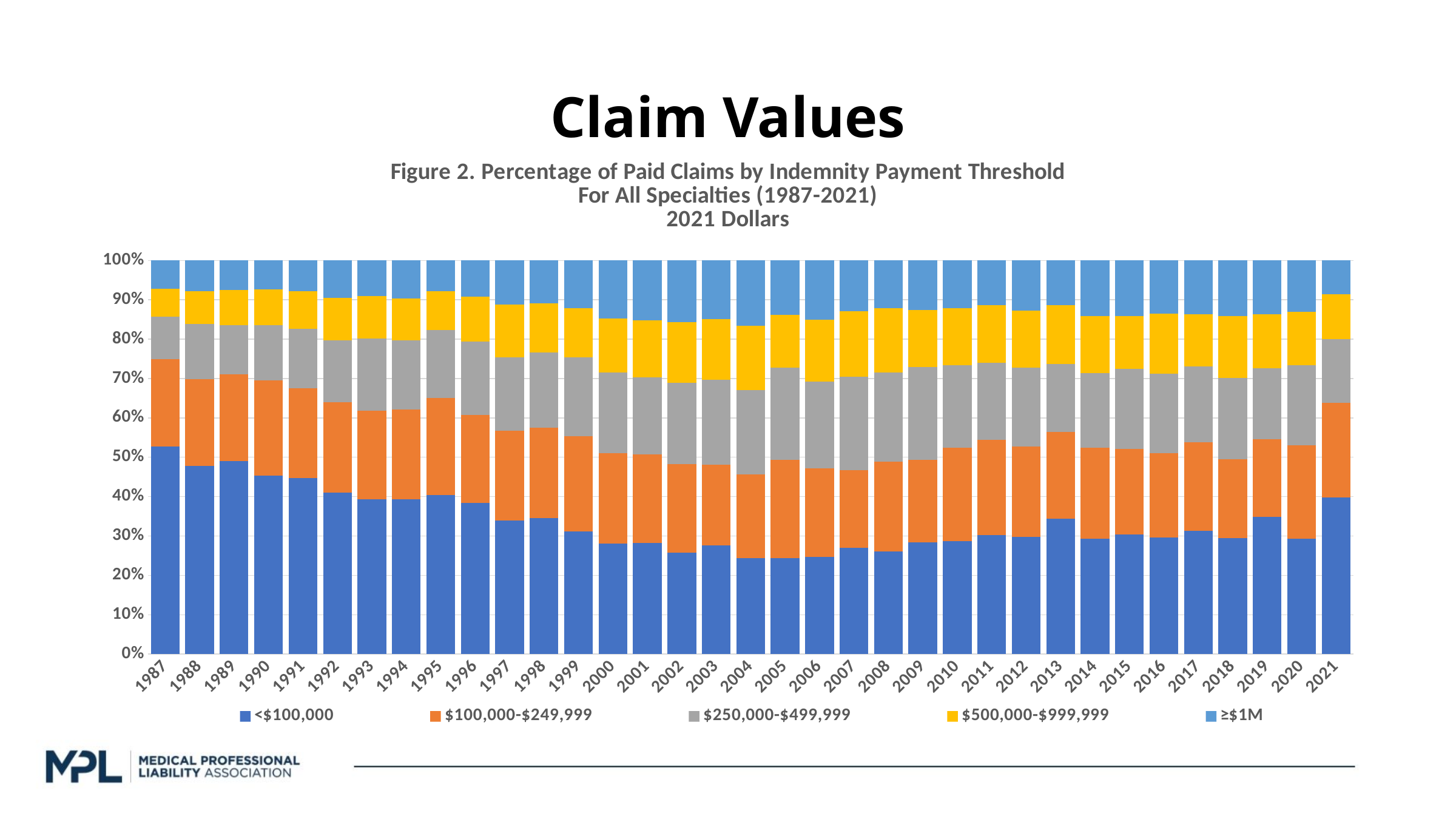
How many series does the legend list? 5 Is the value for <$100,000 in 2021 greater or less than 30%? greater What is the title of the figure shown on the slide? Figure 2. Percentage of Paid Claims by Indemnity Payment Threshold For All Specialties (1987-2021) 2021 Dollars Which year has the larger <$100,000 share, 2012 or 2013? 2013 In which year is the <$100,000 share the highest? 1987 Does the <$100,000 share generally rise or fall from 1987 to 2004? fall Is the value for <$100,000 in 2004 greater or less than 30%? less What kind of chart is shown on the slide? Stacked bar chart How many years are shown along the x axis? 35 Is the value for <$100,000 in 1987 greater or less than 50%? greater Which year has the larger <$100,000 share, 1987 or 2000? 1987